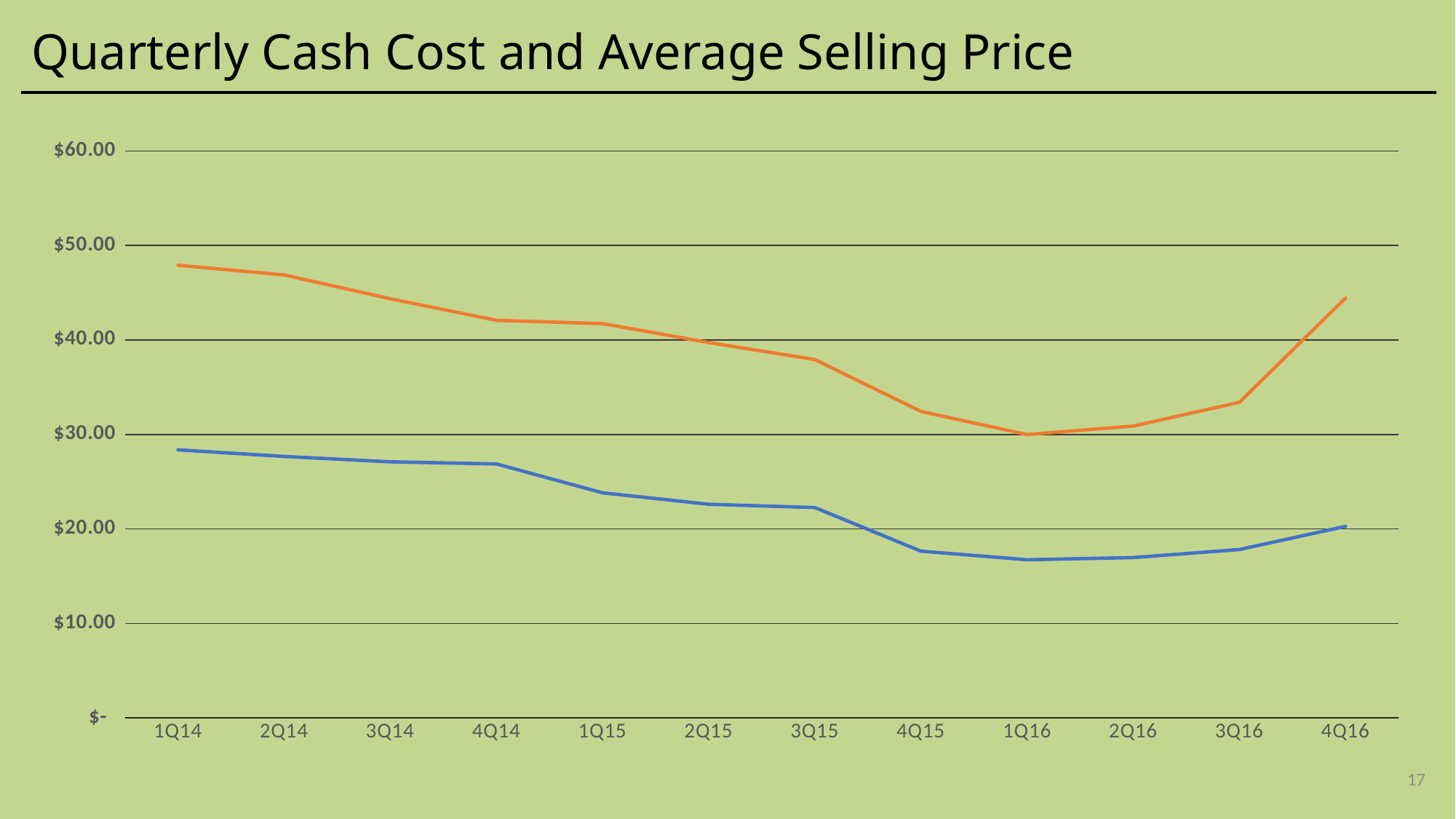
What kind of chart is shown on the slide? line chart Is the value of the orange line at 1Q14 greater or less than $40.00? greater In which quarter does the orange line reach its highest value? 1Q14 How many quarters are shown along the x axis? 12 How many lines are plotted on the chart? 2 Does the orange line rise or fall from 1Q16 to 4Q16? rise Does the blue line rise or fall from 1Q14 to 1Q16? fall Is the value of the blue line at 1Q16 greater or less than $20.00? less Is the value of the orange line at 3Q15 greater or less than $40.00? less What is the title of the chart? Quarterly Cash Cost and Average Selling Price Which line has the higher value at 4Q16, the orange line or the blue line? orange line